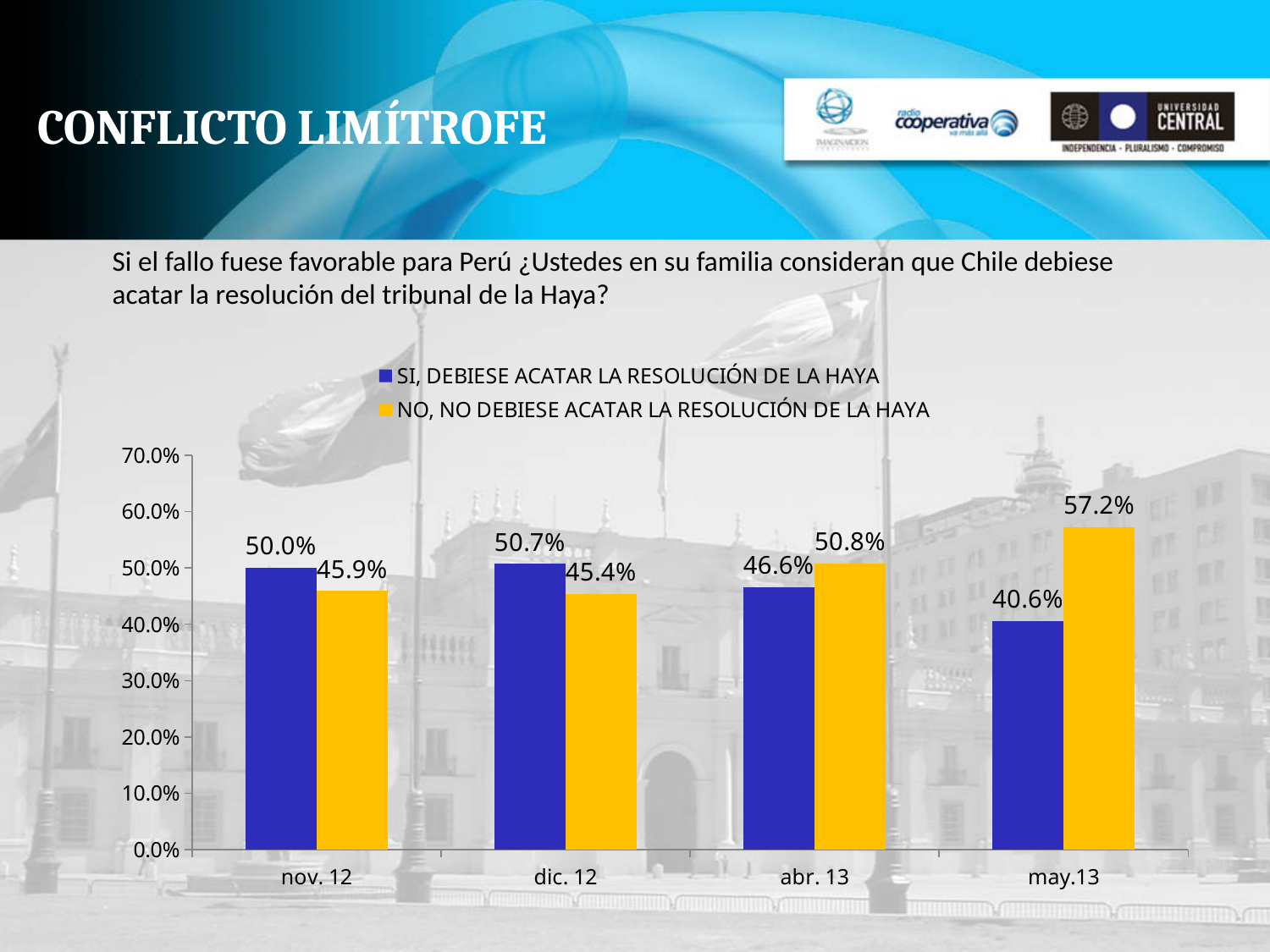
What is the difference between the "NO" and "SI" values in may.13? 16.6% How many series does the legend list? 2 In dic. 12, which is larger: the "SI" value or the "NO" value? SI, DEBIESE ACATAR LA RESOLUCIÓN DE LA HAYA What kind of chart is shown? bar chart In which period is the "SI, DEBIESE ACATAR LA RESOLUCIÓN DE LA HAYA" value lowest? may.13 Does the "NO, NO DEBIESE ACATAR LA RESOLUCIÓN DE LA HAYA" value rise or fall from abr. 13 to may.13? rise What is the value for "NO, NO DEBIESE ACATAR LA RESOLUCIÓN DE LA HAYA" in may.13? 57.2% What is the value for "SI, DEBIESE ACATAR LA RESOLUCIÓN DE LA HAYA" in nov. 12? 50.0% Is the "NO, NO DEBIESE ACATAR LA RESOLUCIÓN DE LA HAYA" value in nov. 12 greater or less than 50.0%? less What is the value for "SI, DEBIESE ACATAR LA RESOLUCIÓN DE LA HAYA" in abr. 13? 46.6% How many periods are shown on the x axis? 4 In which period is the "NO, NO DEBIESE ACATAR LA RESOLUCIÓN DE LA HAYA" value highest? may.13